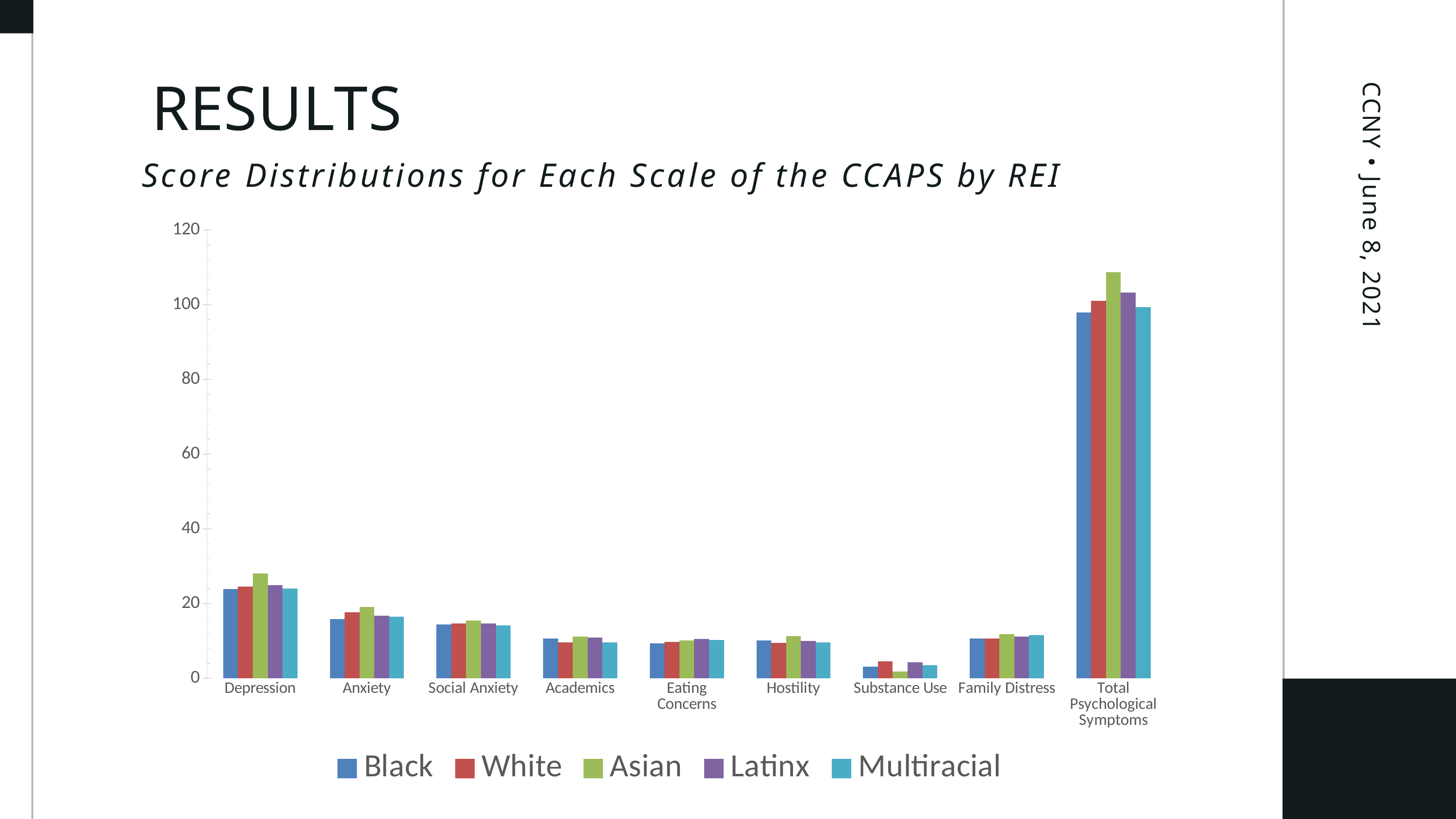
How many series does the legend list? 5 Is the Asian value for Depression greater or less than 20? greater Is the Black value for Anxiety greater or less than 20? less Which category has the highest values across all series? Total Psychological Symptoms In the Total Psychological Symptoms category, which is larger: the Asian bar or the Multiracial bar? Asian How many categories are shown along the x axis of the chart? 9 What kind of chart is shown on the slide? bar chart Which series has the highest bar in the Depression category? Asian Which category has the lowest values across all series? Substance Use Which series has the lowest bar in the Substance Use category? Asian Which series has the highest bar in the Total Psychological Symptoms category? Asian Is the Asian value for Total Psychological Symptoms greater or less than 100? greater